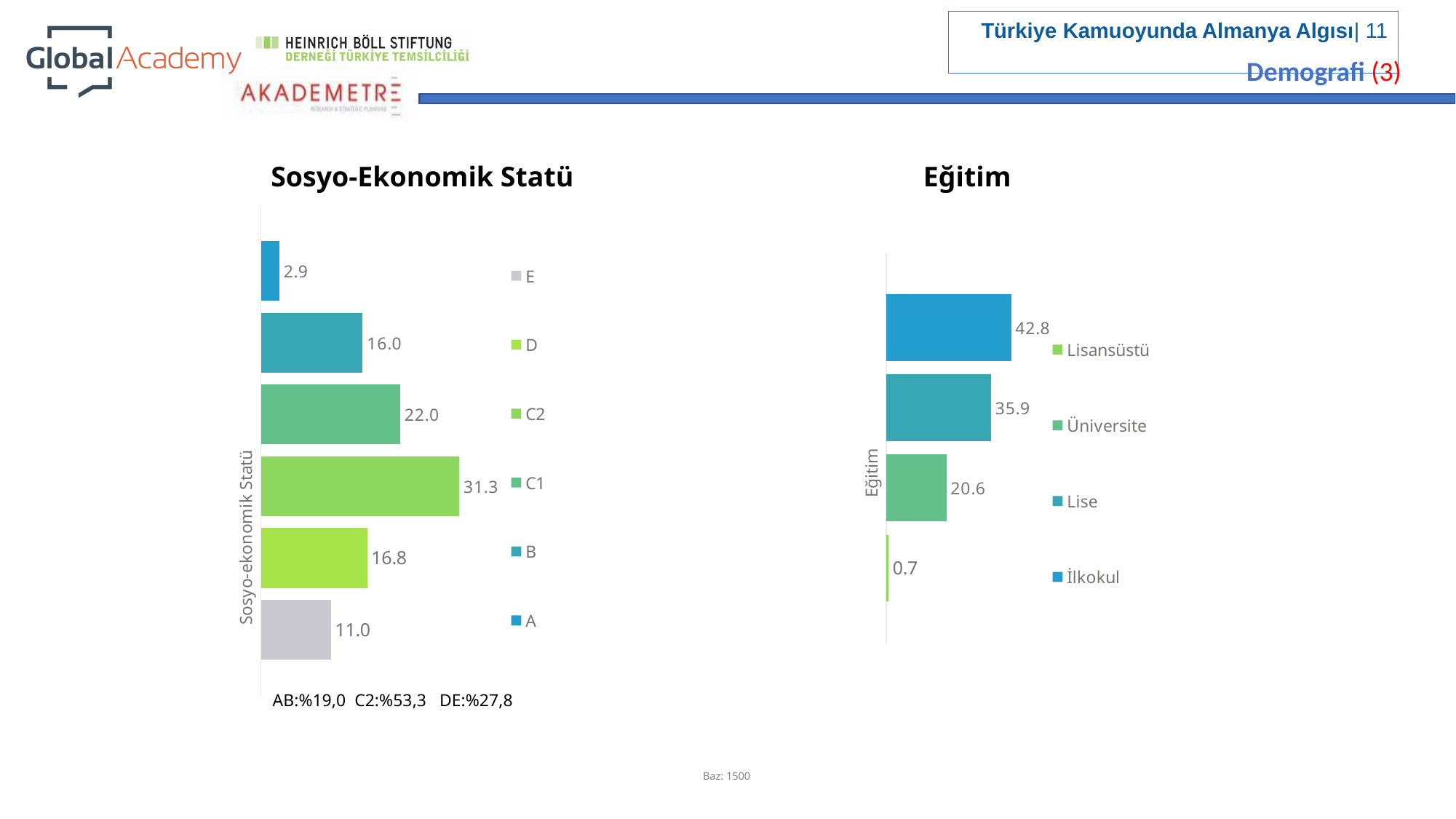
In the Sosyo-Ekonomik Statü chart, which category has the highest value? C2 In the Sosyo-Ekonomik Statü chart, what is the value for C2? 31.3 In the Sosyo-Ekonomik Statü chart, what is the difference between the values for C1 and B? 6.0 In the Sosyo-Ekonomik Statü chart, what is the value for E? 11.0 In the Eğitim chart, what is the difference between the values for İlkokul and Üniversite? 22.2 In the Eğitim chart, which is larger, the value for Üniversite or the value for Lise? Lise In the Sosyo-Ekonomik Statü chart, how many categories are shown in the legend? 6 In the Eğitim chart, what is the value for Lisansüstü? 0.7 What kind of chart is the Eğitim chart? Bar chart In the Eğitim chart, what is the value for Lise? 35.9 In the Sosyo-Ekonomik Statü chart, which category has the lowest value? A In the Eğitim chart, which category has the highest value? İlkokul